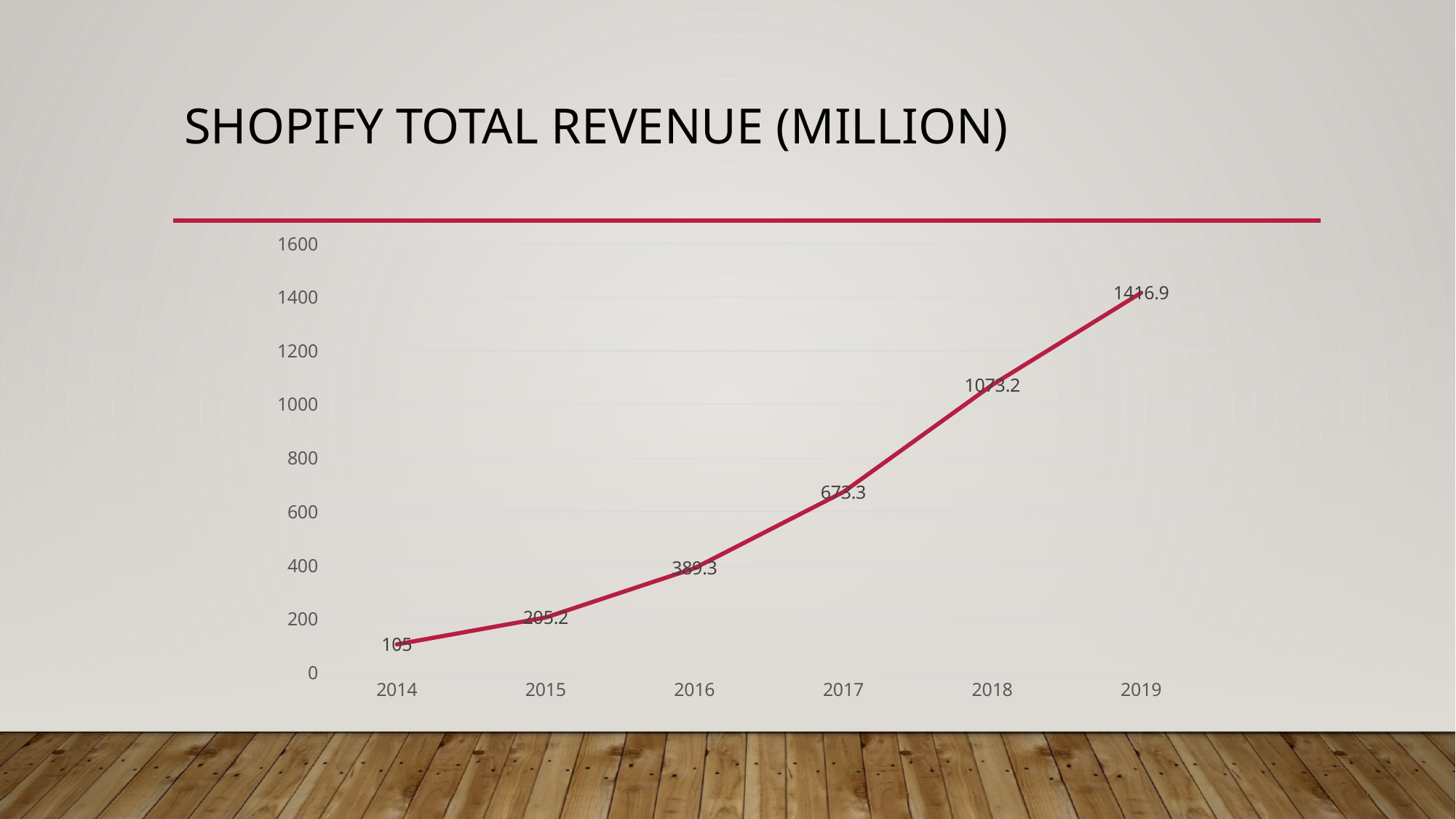
Which year has higher total revenue, 2016 or 2017? 2017 What is the Shopify total revenue for 2018? 1073.2 What is the Shopify total revenue for 2017? 673.3 What is the difference in total revenue between 2019 and 2018? 343.7 Is the value for 2018 greater or less than 1000? greater How many years are plotted on the x axis? 6 What is the Shopify total revenue for 2019? 1416.9 What is the Shopify total revenue for 2015? 205.2 Which year has the highest total revenue? 2019 Which year has the lowest total revenue? 2014 What kind of chart is shown on the slide? line chart Do the values rise or fall from 2014 to 2019? rise